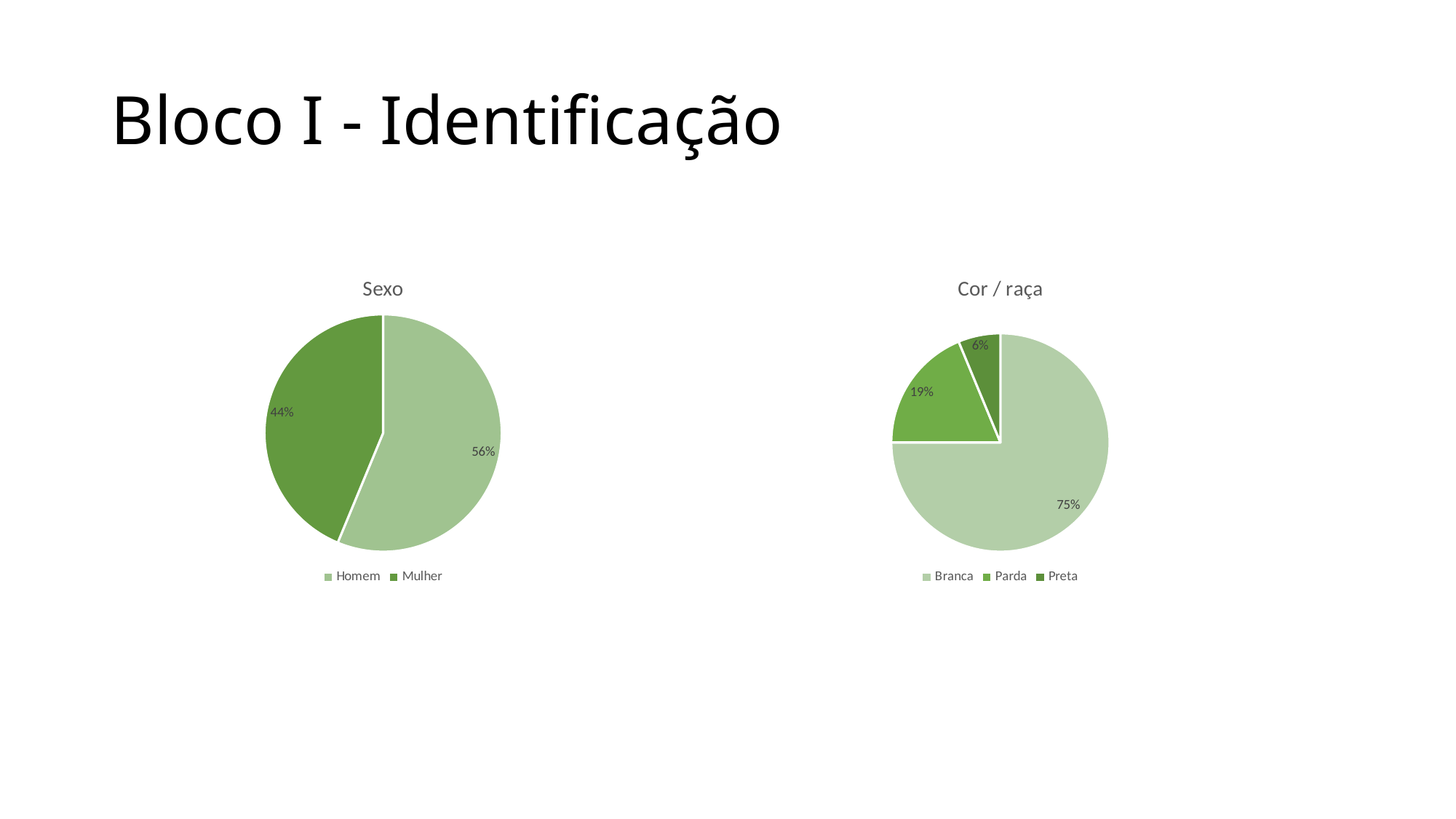
In the 'Cor / raça' chart, what share of the pie is Parda? 19% In the 'Sexo' chart, what share of the pie is Mulher? 44% In the 'Cor / raça' chart, what share of the pie is Branca? 75% In the 'Sexo' chart, how many categories does the legend list? 2 In the 'Sexo' chart, which category has the largest slice? Homem In the 'Cor / raça' chart, which is larger, Parda or Preta? Parda In the 'Cor / raça' chart, how many categories are shown? 3 In the 'Sexo' chart, what is the difference between the Homem and Mulher shares? 12% In the 'Cor / raça' chart, which category has the smallest slice? Preta What kind of chart is the 'Cor / raça' chart? Pie chart